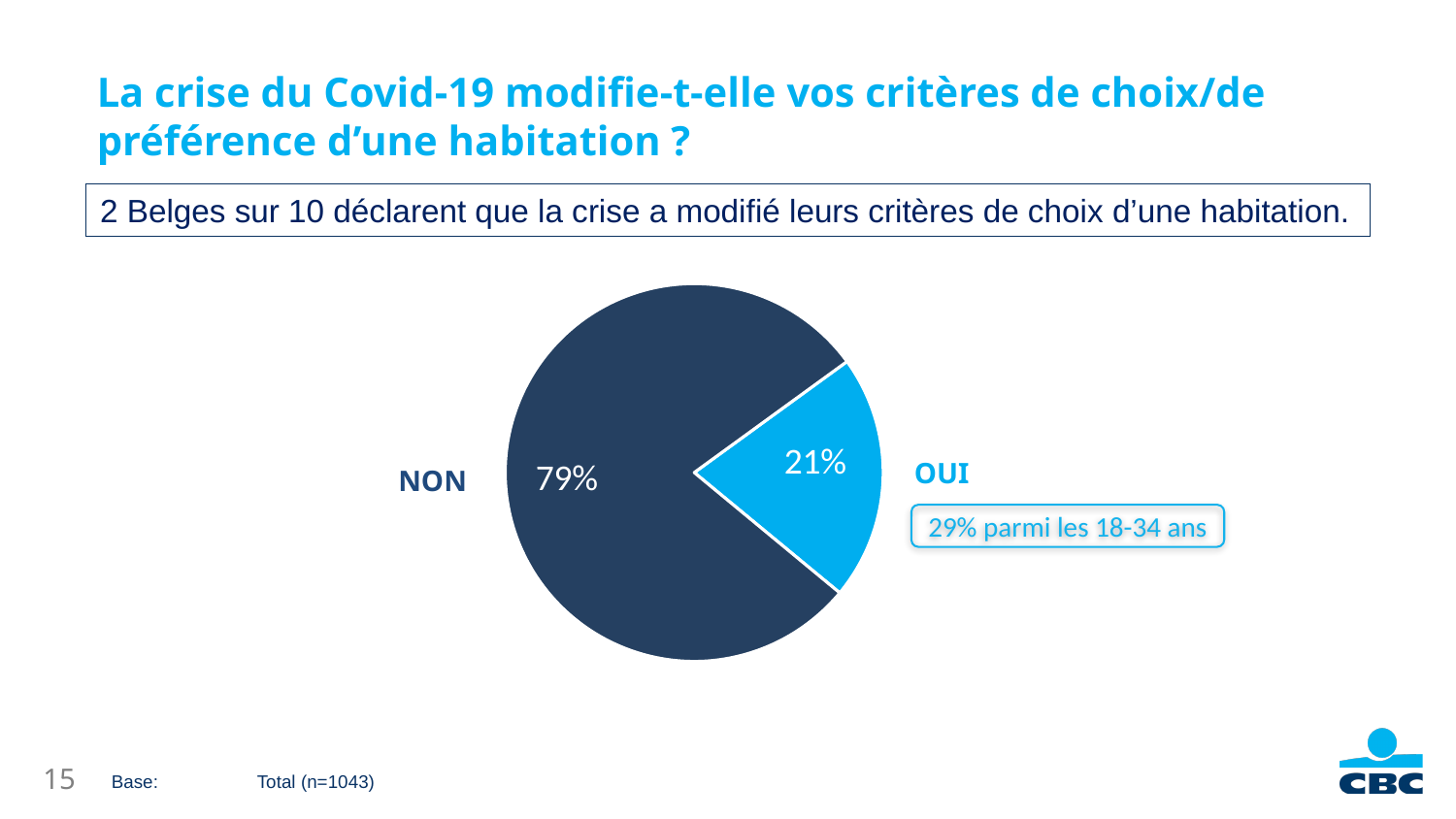
Which is larger, the OUI slice or the NON slice? NON What percentage of respondents answered OUI? 21% What is the sample size (n) given in the base note below the chart? 1043 What is the difference in percentage points between the NON and OUI slices? 58 Which slice of the pie is the smallest? OUI What kind of chart is shown on the slide? Pie chart What colour is the OUI slice of the pie? Light blue What percentage of 18-34 year olds answered OUI, according to the callout next to the chart? 29% What percentage of respondents answered NON? 79% Which slice of the pie is the largest? NON What share of the pie does the OUI slice represent? 21% How many slices does the pie chart have? 2